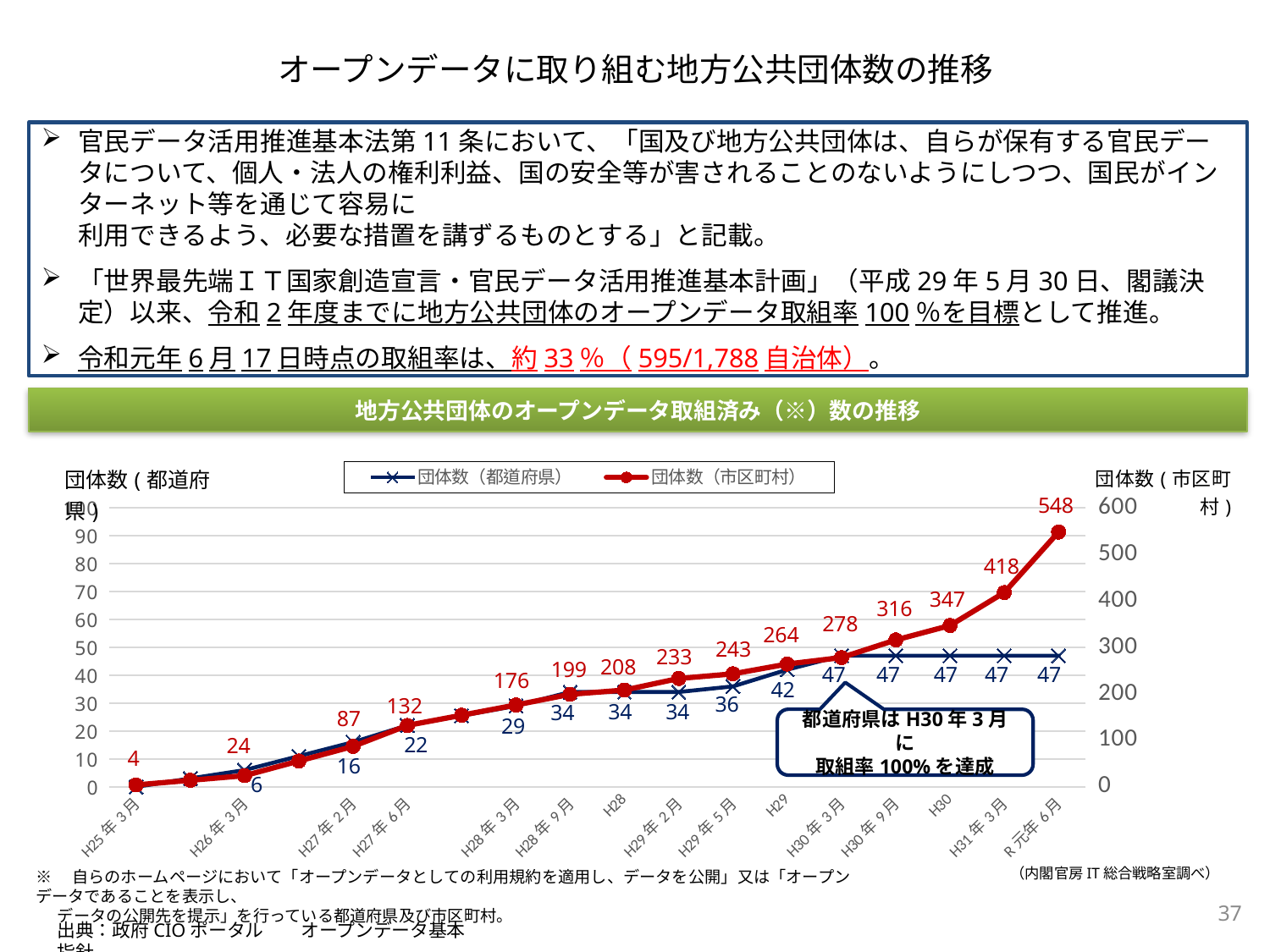
What is the value of 団体数（市区町村） at R元年6月? 548 At which x-axis category is 団体数（市区町村） lowest? H25年3月 What is the value of 団体数（都道府県） at H29? 42 How many series does the legend list? 2 What is the value of 団体数（市区町村） at H31年3月? 418 At which x-axis category is 団体数（市区町村） highest? R元年6月 What kind of chart is shown on the slide? Line chart Do the values of 団体数（市区町村） rise or fall from H25年3月 to R元年6月? Rise What is the difference between 団体数（市区町村） at R元年6月 and at H31年3月? 130 What is the value of 団体数（市区町村） at H27年6月? 132 Which is larger for 団体数（市区町村）: the value at H30年9月 or at H30? H30 What is the difference between 団体数（都道府県） at H29 and at H29年5月? 6